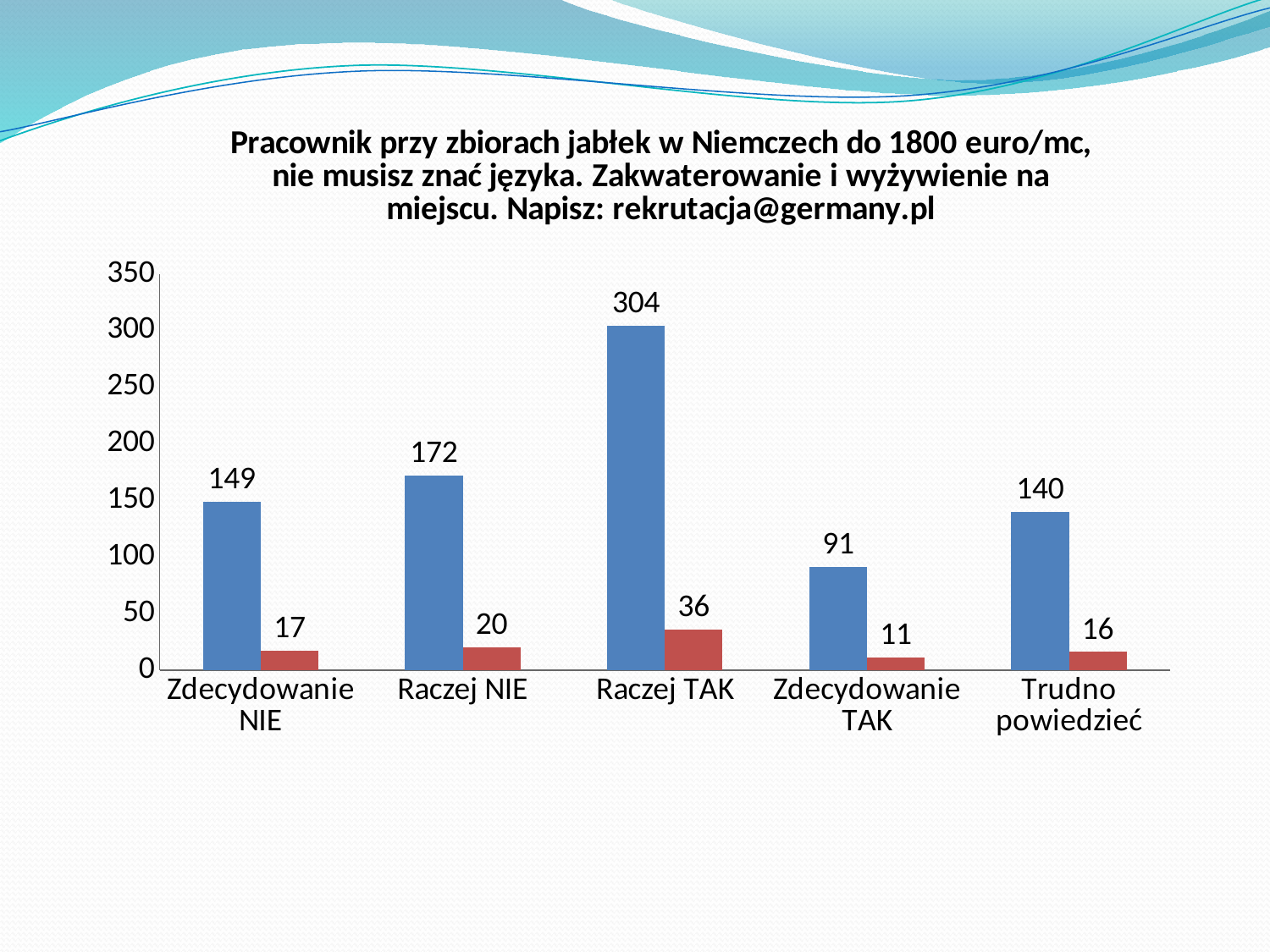
What type of chart is shown on the slide? Bar chart How many categories are shown on the x axis? 5 What is the value of the red bar for Raczej TAK? 36 Which category has the highest blue bar? Raczej TAK What is the value of the blue bar for Raczej TAK? 304 What is the value of the red bar for Zdecydowanie NIE? 17 What is the value of the blue bar for Trudno powiedzieć? 140 Which category has the lowest red bar? Zdecydowanie TAK What is the difference between the blue bar values for Raczej NIE and Zdecydowanie NIE? 23 How many data series are plotted in the chart? 2 Which is larger: the blue bar for Zdecydowanie NIE or the blue bar for Trudno powiedzieć? Zdecydowanie NIE Is the blue bar for Zdecydowanie TAK greater or less than 100? less